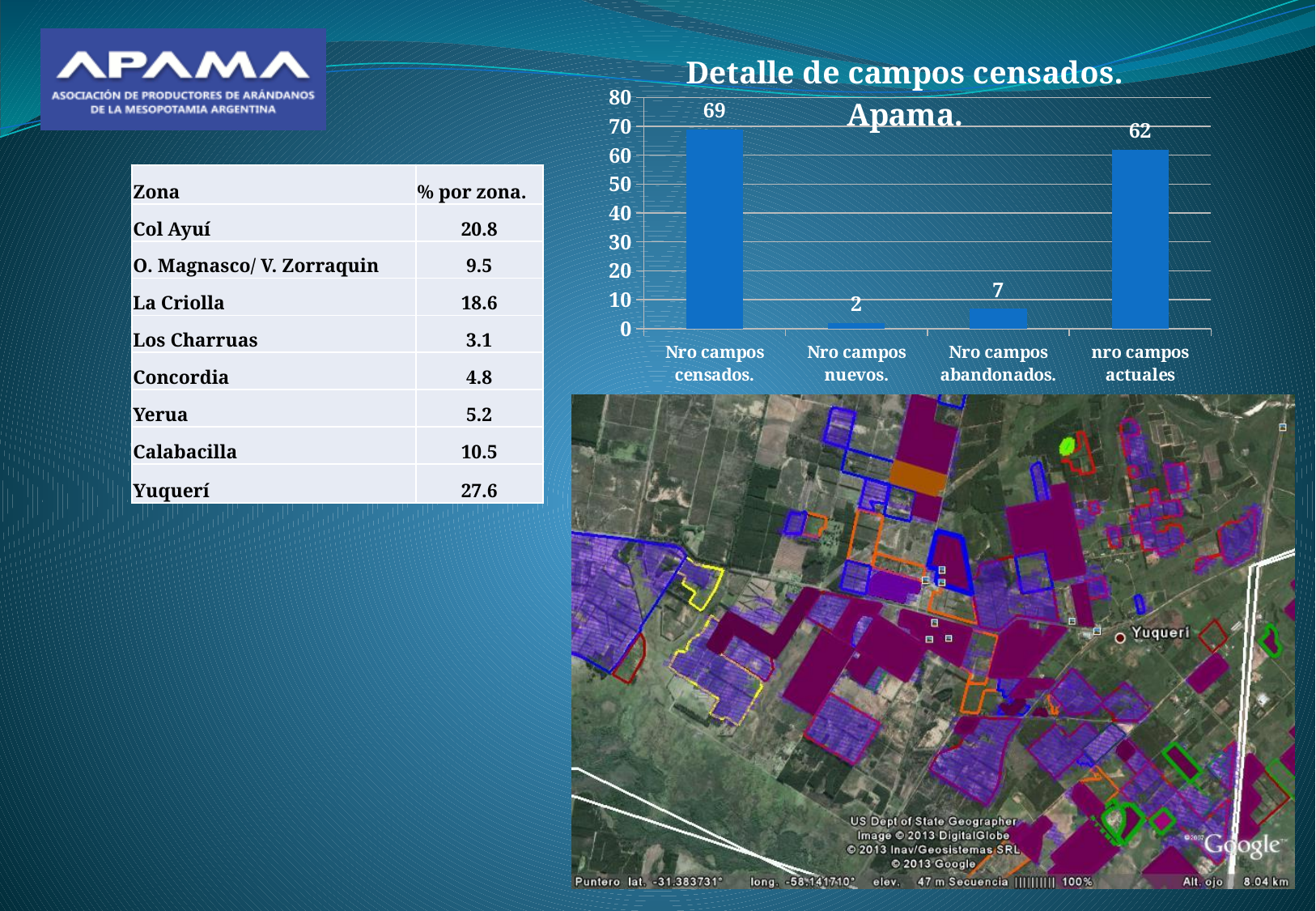
What is the value for "Nro campos nuevos." in the chart? 2 What is the difference between "Nro campos censados." and "nro campos actuales"? 7 What is the value for "Nro campos abandonados." in the chart? 7 What is the value for "nro campos actuales" in the chart? 62 What is the title of the chart? Detalle de campos censados. Apama. Which is larger, "Nro campos abandonados." or "Nro campos nuevos."? Nro campos abandonados. How many categories are shown in the chart? 4 What is the difference between "Nro campos abandonados." and "Nro campos nuevos."? 5 What is the value for "Nro campos censados." in the chart? 69 Which category has the highest value in the chart? Nro campos censados. What kind of chart is shown on the slide? Bar chart Which category has the lowest value in the chart? Nro campos nuevos.